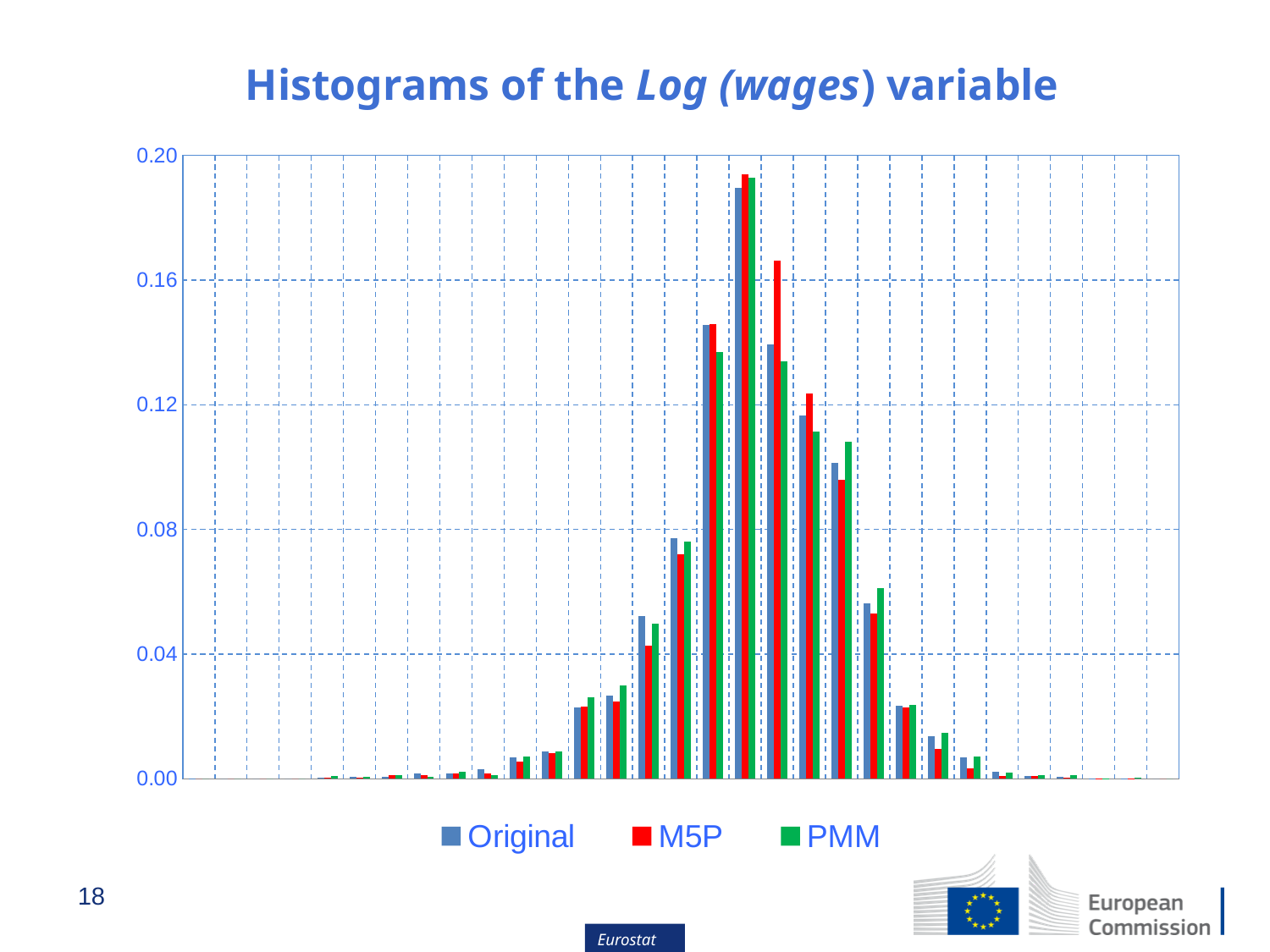
What kind of chart is shown on the slide? bar chart Which series has the tallest bar in the group immediately to the right of the tallest group? M5P Is the tallest Original bar greater or less than 0.16? greater In the bar group immediately to the right of the tallest group, which is larger, the M5P bar or the PMM bar? M5P Moving from the tallest bar group toward the right edge of the chart, do the Original bars rise or fall? fall Is the tallest M5P bar greater or less than 0.20? less Which colour represents the M5P series in the legend? red How many series does the legend list? 3 What is the title of the chart? Histograms of the Log (wages) variable In the bar group immediately to the right of the tallest group, is the M5P bar greater or less than 0.16? greater